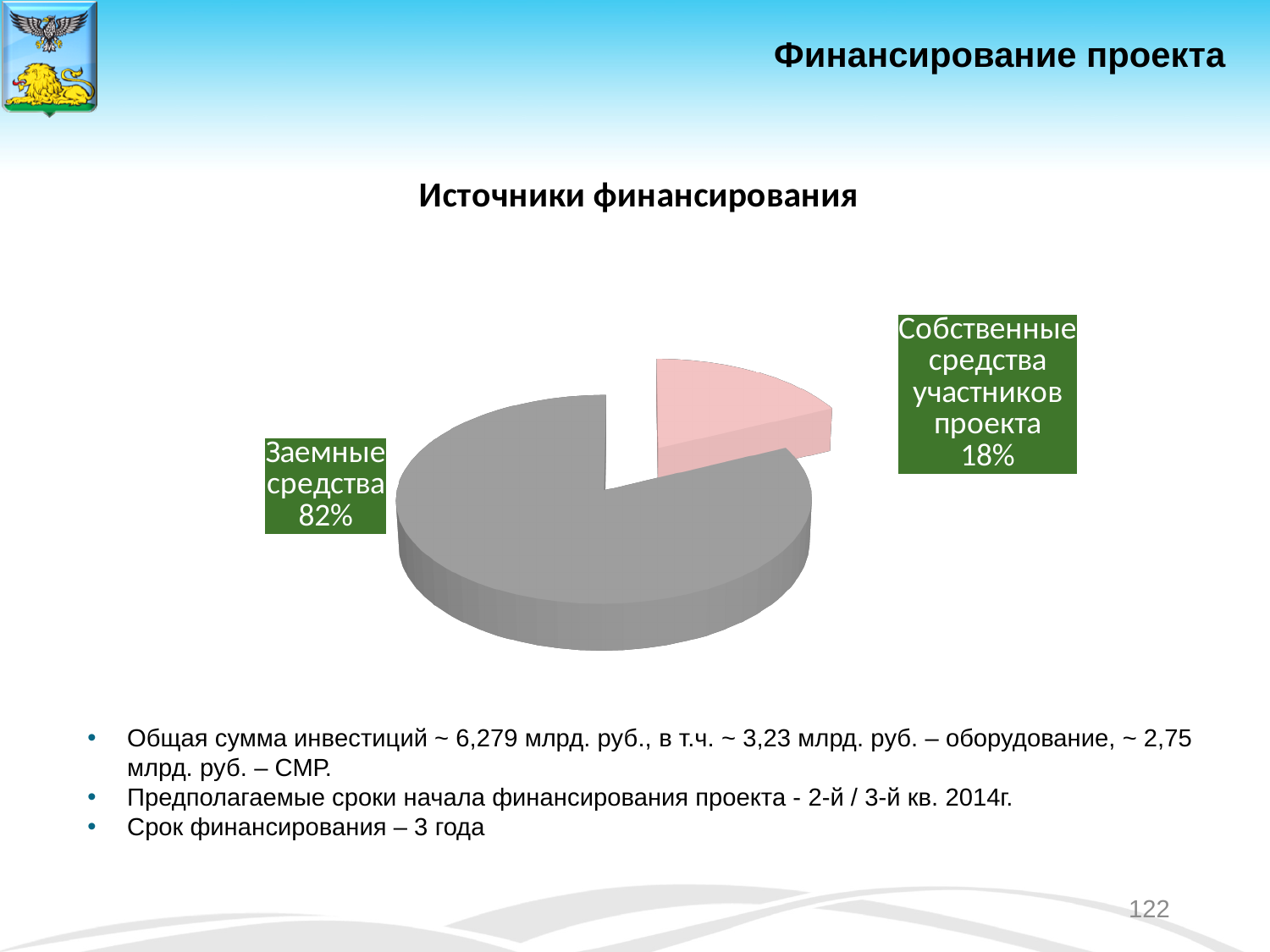
What is the difference in percentage points between "Заемные средства" and "Собственные средства участников проекта"? 64 Which slice of the pie is the smallest? Собственные средства участников проекта What kind of chart is shown on the slide? Pie chart What is the title of the chart? Источники финансирования What share of the pie does "Заемные средства" represent? 82% How many slices does the pie chart have? 2 What share of the pie does "Собственные средства участников проекта" represent? 18% Which slice of the pie is the largest? Заемные средства Which is larger: the share of "Заемные средства" or the share of "Собственные средства участников проекта"? Заемные средства What colour is the slice for "Собственные средства участников проекта"? Pink